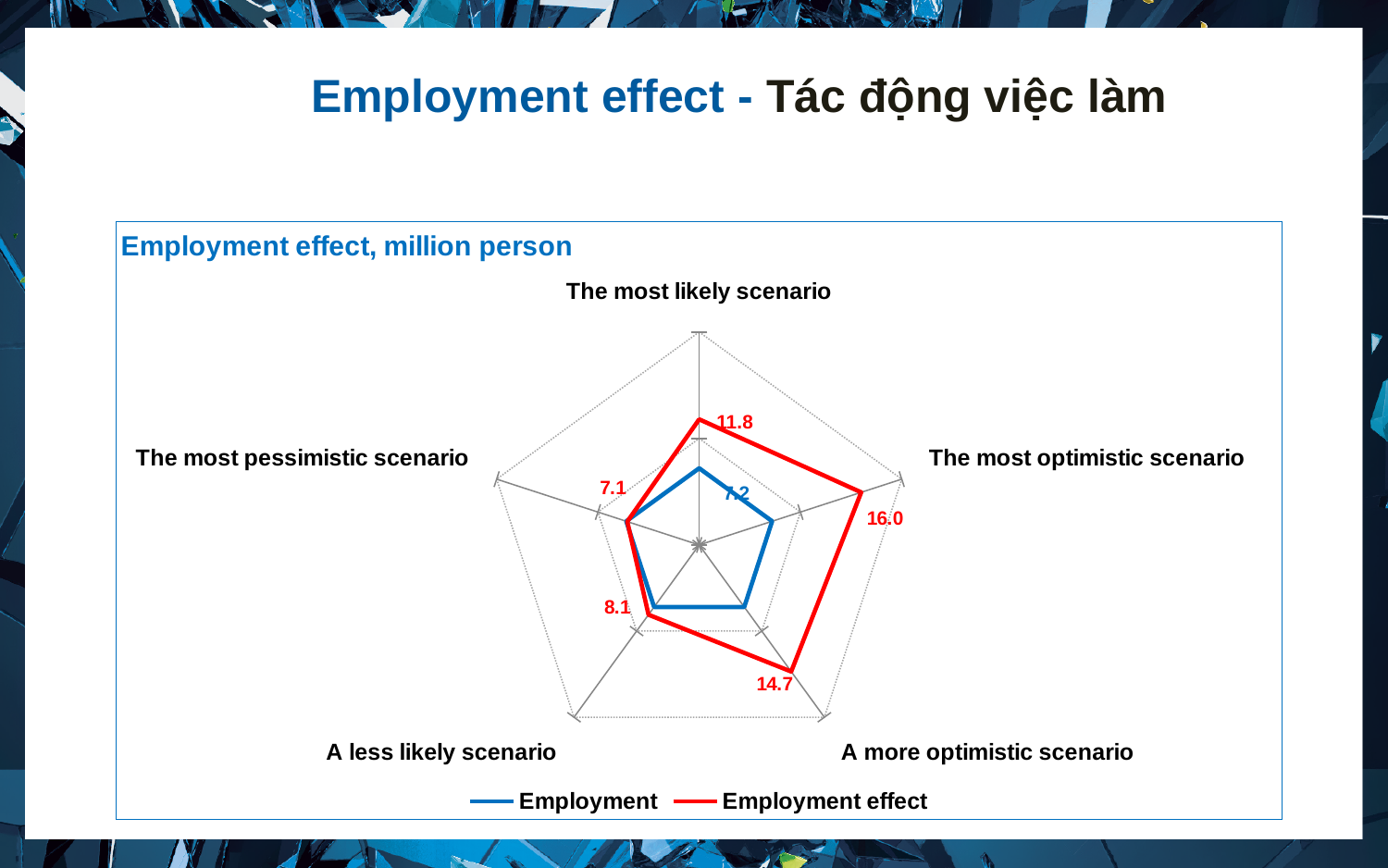
What kind of chart is shown on the slide? Radar chart What is the title of the chart? Employment effect, million person How many scenarios (categories) are plotted on the radar chart? 5 Which scenario has the lowest Employment effect value? The most pessimistic scenario What is the Employment effect value for the most optimistic scenario? 16.0 How many series does the legend list? 2 What is the Employment effect value for the most likely scenario? 11.8 Which scenario has the highest Employment effect value? The most optimistic scenario What is the Employment effect value for a more optimistic scenario? 14.7 What is the Employment effect value for a less likely scenario? 8.1 What is the Employment effect value for the most pessimistic scenario? 7.1 What is the difference between the Employment effect values for the most optimistic scenario and the most pessimistic scenario? 8.9